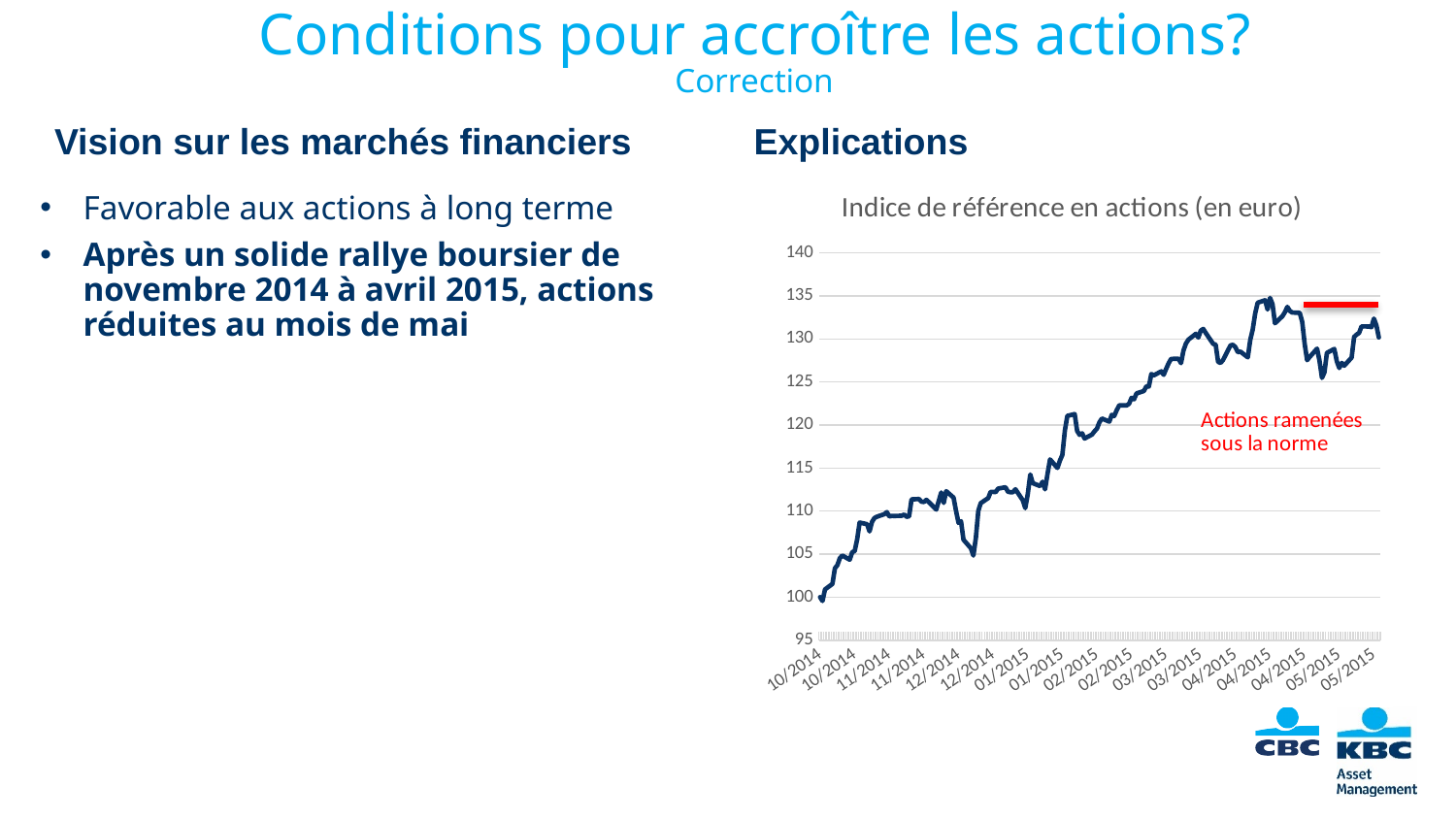
Is the value of the index at the end of the series in 05/2015 greater or less than 125? greater How many lines are plotted on the chart? 1 Overall, does the index rise or fall from 10/2014 to 05/2015? rise What is the highest value shown on the vertical axis of the chart? 140 Which is higher: the index value in 10/2014 or in 03/2015? 03/2015 What is the value of the index at the start of the series in 10/2014? 100 How many date labels are shown along the x axis of the chart? 16 What is the title of the chart on the slide? Indice de référence en actions (en euro) What kind of chart is shown on the slide? line chart Is the value of the index in 11/2014 greater or less than 115? less Is the value of the index in 02/2015 greater or less than 115? greater